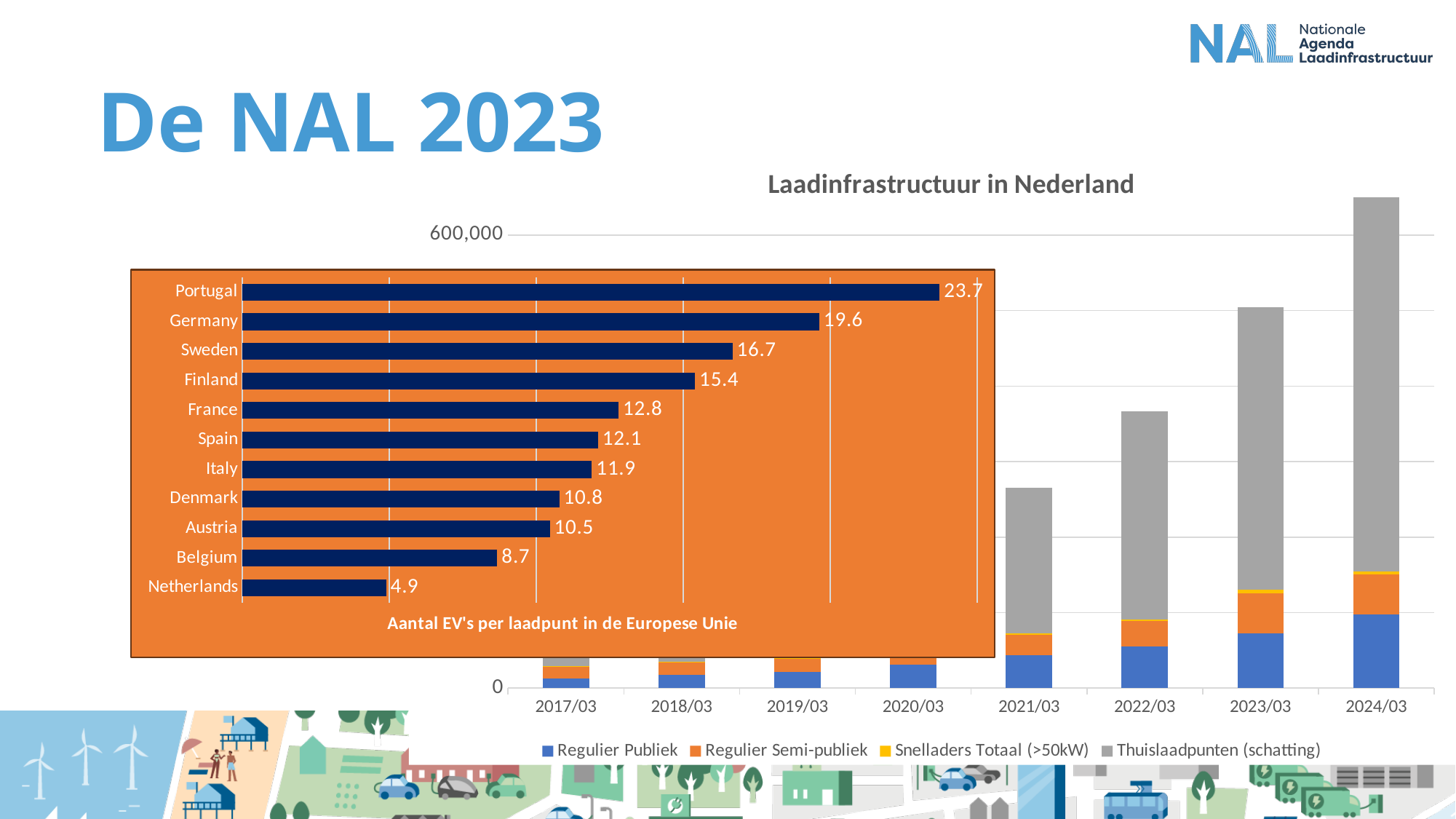
In the chart titled "Aantal EV's per laadpunt in de Europese Unie", what is the value for the Netherlands? 4.9 How many countries are shown in the chart titled "Aantal EV's per laadpunt in de Europese Unie"? 11 In the chart titled "Aantal EV's per laadpunt in de Europese Unie", which country has the lowest value? Netherlands How many series does the legend of the chart titled "Laadinfrastructuur in Nederland" list? 4 In the chart titled "Laadinfrastructuur in Nederland", is the total for 2024/03 greater or less than 600,000? greater In the chart titled "Aantal EV's per laadpunt in de Europese Unie", which has a larger value, Denmark or Austria? Denmark What kind of chart is the chart titled "Aantal EV's per laadpunt in de Europese Unie"? Bar chart In the chart titled "Aantal EV's per laadpunt in de Europese Unie", what is the difference between the values for Germany and Sweden? 2.9 In the chart titled "Laadinfrastructuur in Nederland", which legend entry is shown in grey? Thuislaadpunten (schatting) In the chart titled "Aantal EV's per laadpunt in de Europese Unie", which country has the highest value? Portugal In the chart titled "Aantal EV's per laadpunt in de Europese Unie", what is the value for Portugal? 23.7 In the chart titled "Aantal EV's per laadpunt in de Europese Unie", what is the value for France? 12.8